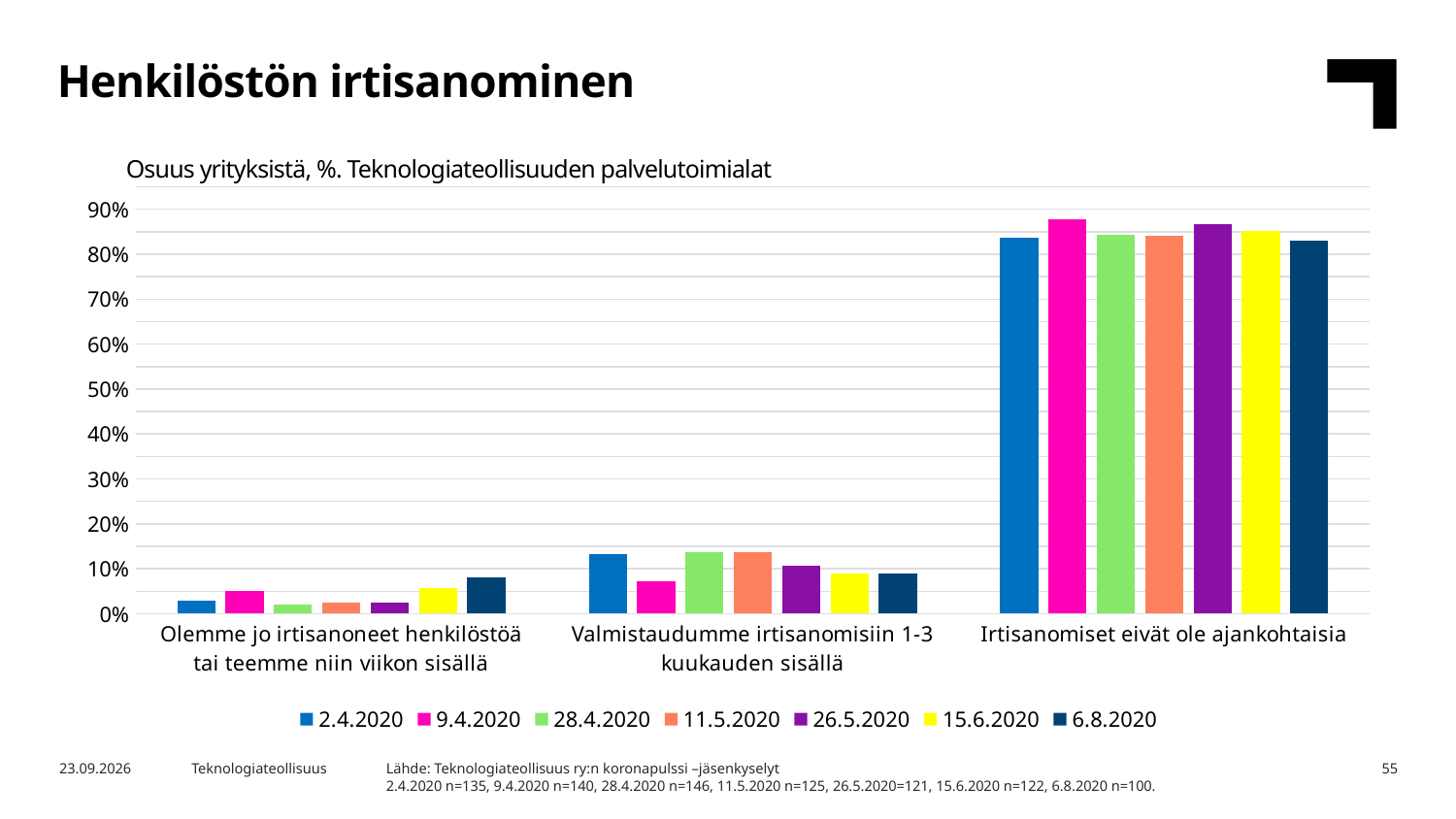
How many series does the chart legend list? 7 In the category 'Valmistaudumme irtisanomisiin 1-3 kuukauden sisällä', which is larger: the value for 2.4.2020 or for 9.4.2020? 2.4.2020 What is the subtitle shown above the chart? Osuus yrityksistä, %. Teknologiateollisuuden palvelutoimialat Is the value for 6.8.2020 in the category 'Olemme jo irtisanoneet henkilöstöä tai teemme niin viikon sisällä' greater or less than 10%? less Within the category 'Irtisanomiset eivät ole ajankohtaisia', which survey date has the highest bar? 9.4.2020 Is the value for 9.4.2020 in the category 'Irtisanomiset eivät ole ajankohtaisia' greater or less than 80%? greater Within the category 'Olemme jo irtisanoneet henkilöstöä tai teemme niin viikon sisällä', which survey date has the highest bar? 6.8.2020 Is the value for 2.4.2020 in the category 'Valmistaudumme irtisanomisiin 1-3 kuukauden sisällä' greater or less than 10%? greater Which category has the highest values in the chart? Irtisanomiset eivät ole ajankohtaisia How many categories are shown on the x axis of the chart? 3 What kind of chart is shown on the slide? bar chart In the category 'Irtisanomiset eivät ole ajankohtaisia', which is larger: the value for 9.4.2020 or for 6.8.2020? 9.4.2020